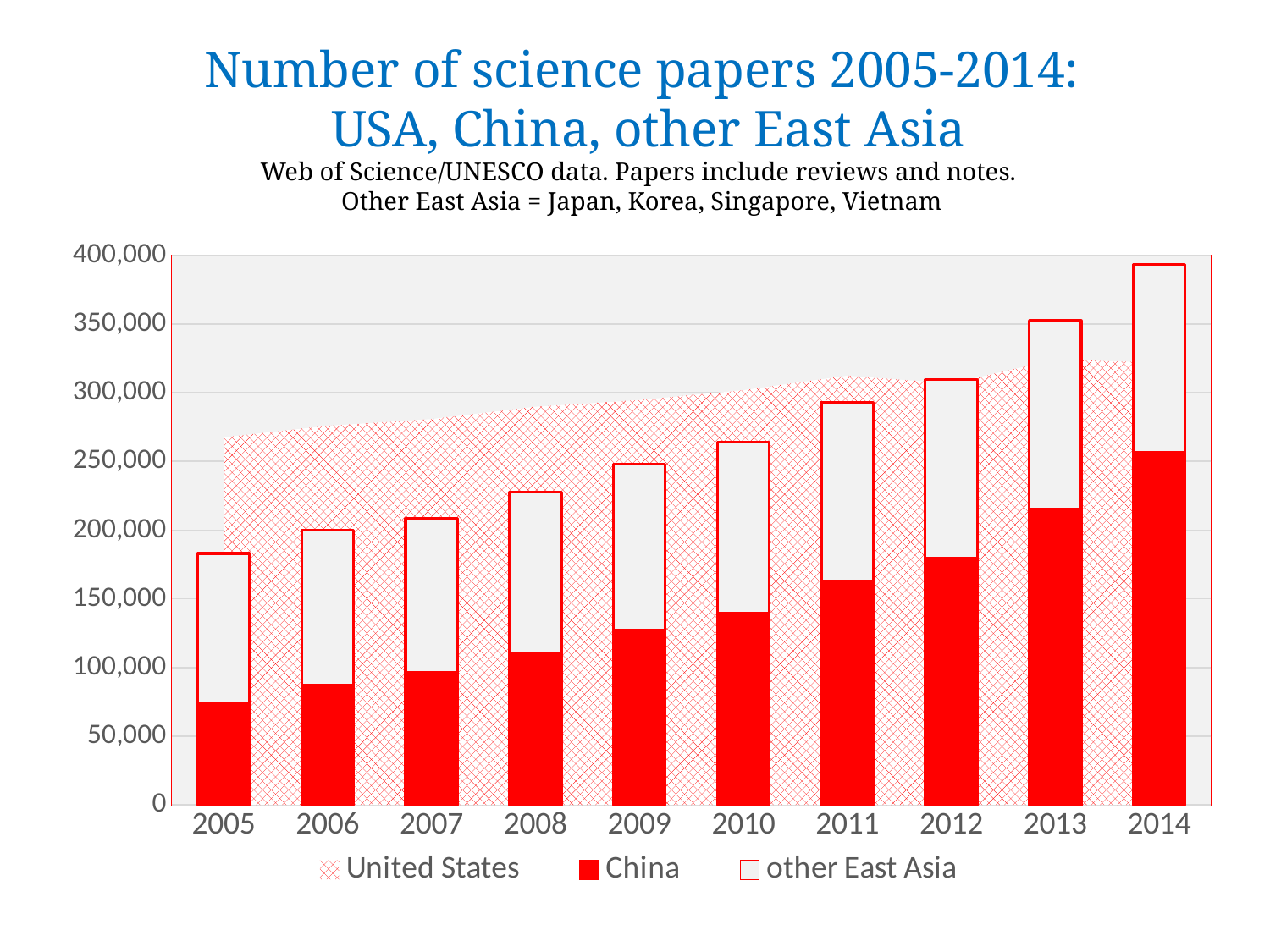
In 2005, which is larger: the United States value or the stacked total of China plus other East Asia? United States Which year has the shortest stacked bar (China plus other East Asia)? 2005 How many years are shown on the x axis? 10 How many series does the legend list? 3 What kind of chart is shown on the slide? a combination chart: stacked bars (China, other East Asia) with a hatched area for the United States Which year has the tallest stacked bar (China plus other East Asia)? 2014 Do the China values rise or fall from 2005 to 2014? rise Is the value for China in 2005 greater or less than 100,000? less Is the value for China in 2014 greater or less than 200,000? greater Which series is drawn as a solid red bar? China Is the total of the stacked bar for 2014 greater or less than 350,000? greater